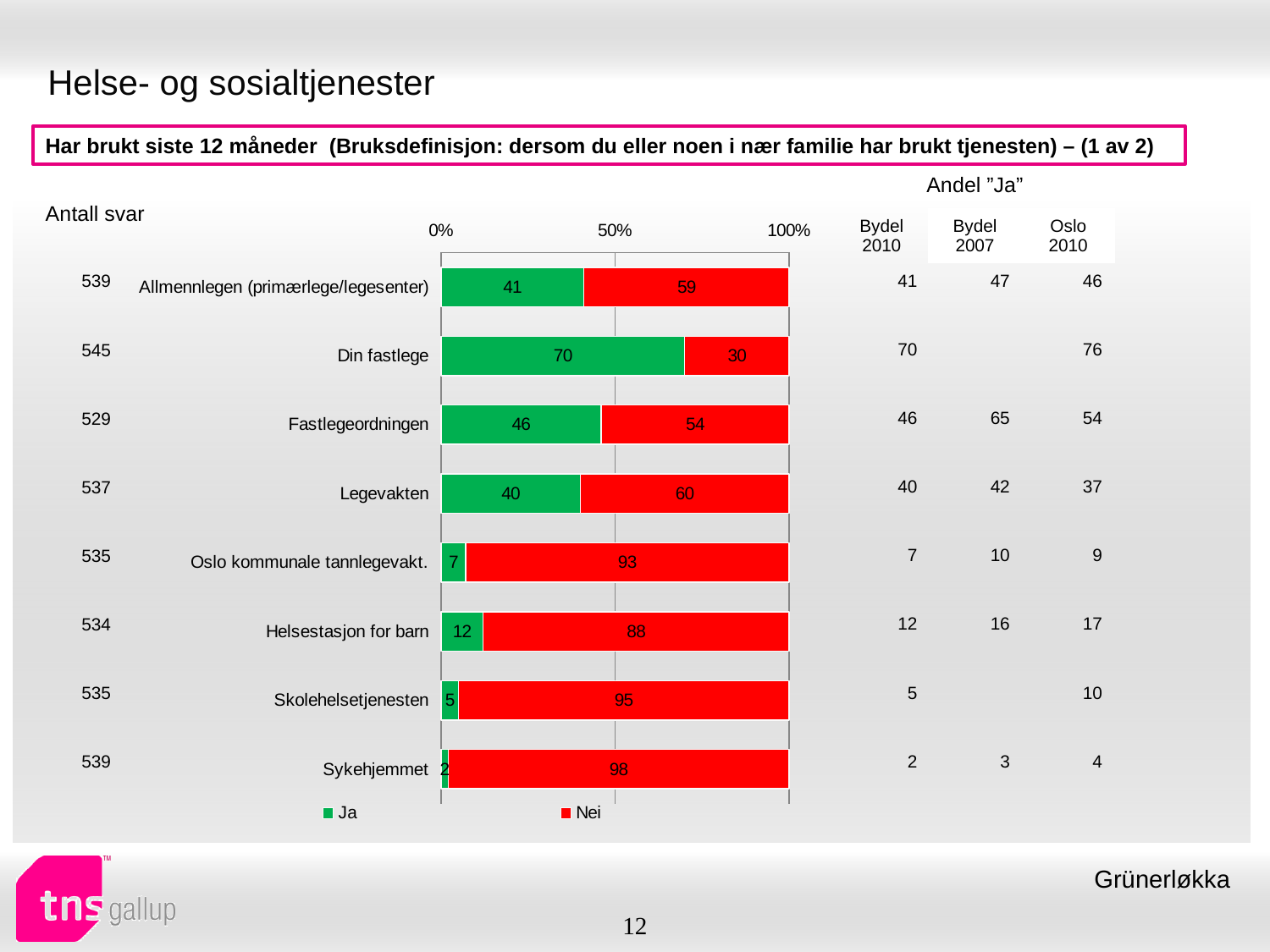
How many categories are shown in the chart? 8 How many series does the legend list? 2 Which is larger, the "Ja" value for Fastlegeordningen or for Legevakten? Fastlegeordningen Which category has the highest "Ja" value? Din fastlege What is the difference between the "Nei" values for Legevakten and Allmennlegen (primærlege/legesenter)? 1 What is the total of the stacked bar for Fastlegeordningen? 100 Which category has the lowest "Ja" value? Sykehjemmet What is the "Nei" value for Oslo kommunale tannlegevakt.? 93 What is the "Ja" value for Helsestasjon for barn? 12 What is the "Ja" value for Din fastlege? 70 Is the "Nei" value for Skolehelsetjenesten greater or less than 50%? greater What kind of chart is shown? stacked bar chart